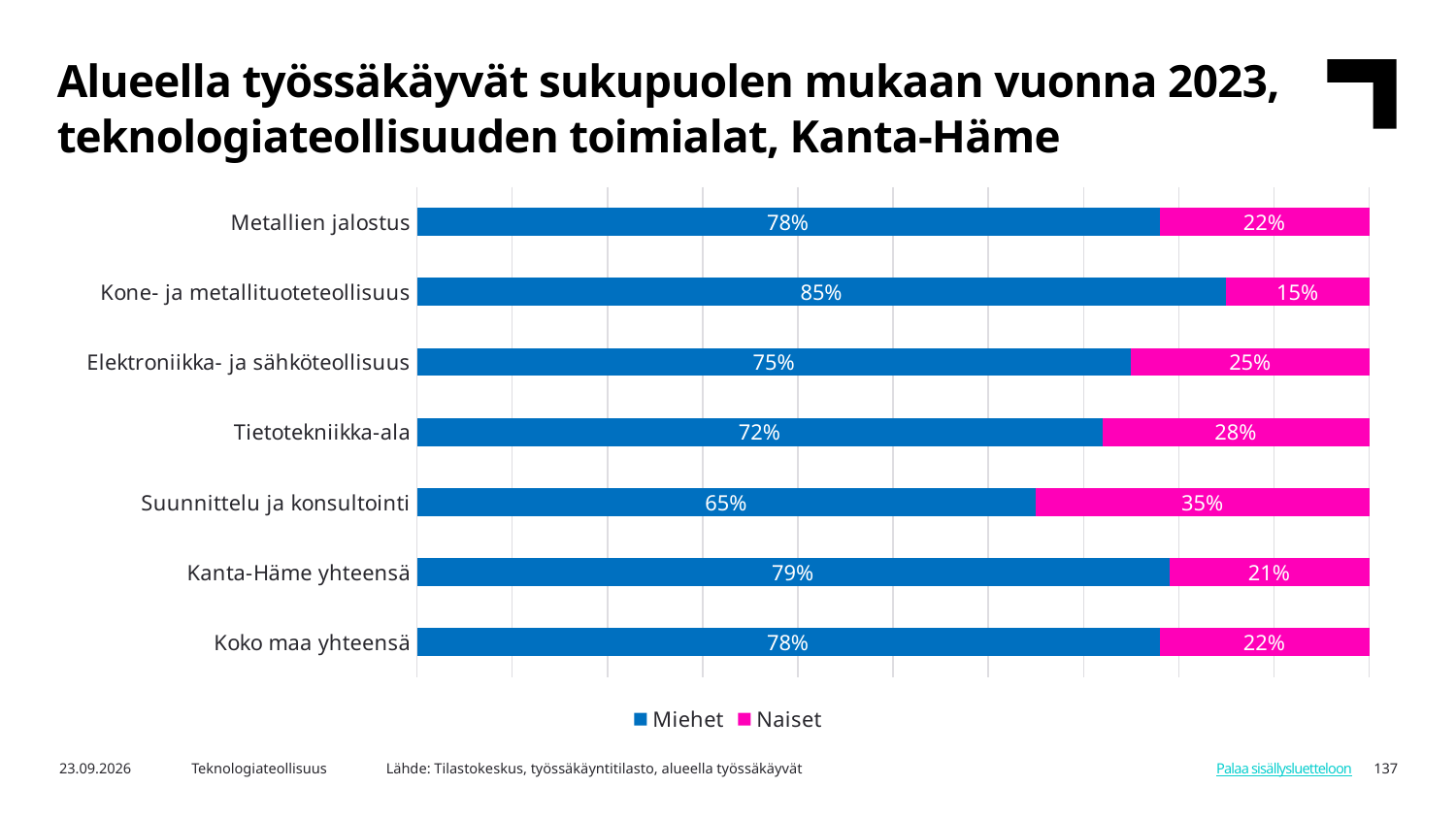
What kind of chart is shown on the slide? Stacked bar chart Which category has the highest Miehet share? Kone- ja metallituoteteollisuus What is the Miehet share for Kone- ja metallituoteteollisuus? 85% What is the Naiset share for Tietotekniikka-ala? 28% How many series does the legend list? 2 What are the two series named in the legend? Miehet and Naiset What is the Miehet share for Kanta-Häme yhteensä? 79% How many categories are shown on the chart? 7 What is the difference between the Naiset share for Suunnittelu ja konsultointi and the Naiset share for Kone- ja metallituoteteollisuus? 20 percentage points What is the Naiset share for Suunnittelu ja konsultointi? 35% Which is larger: the Naiset share for Elektroniikka- ja sähköteollisuus or the Naiset share for Metallien jalostus? Elektroniikka- ja sähköteollisuus Which category has the lowest Miehet share? Suunnittelu ja konsultointi